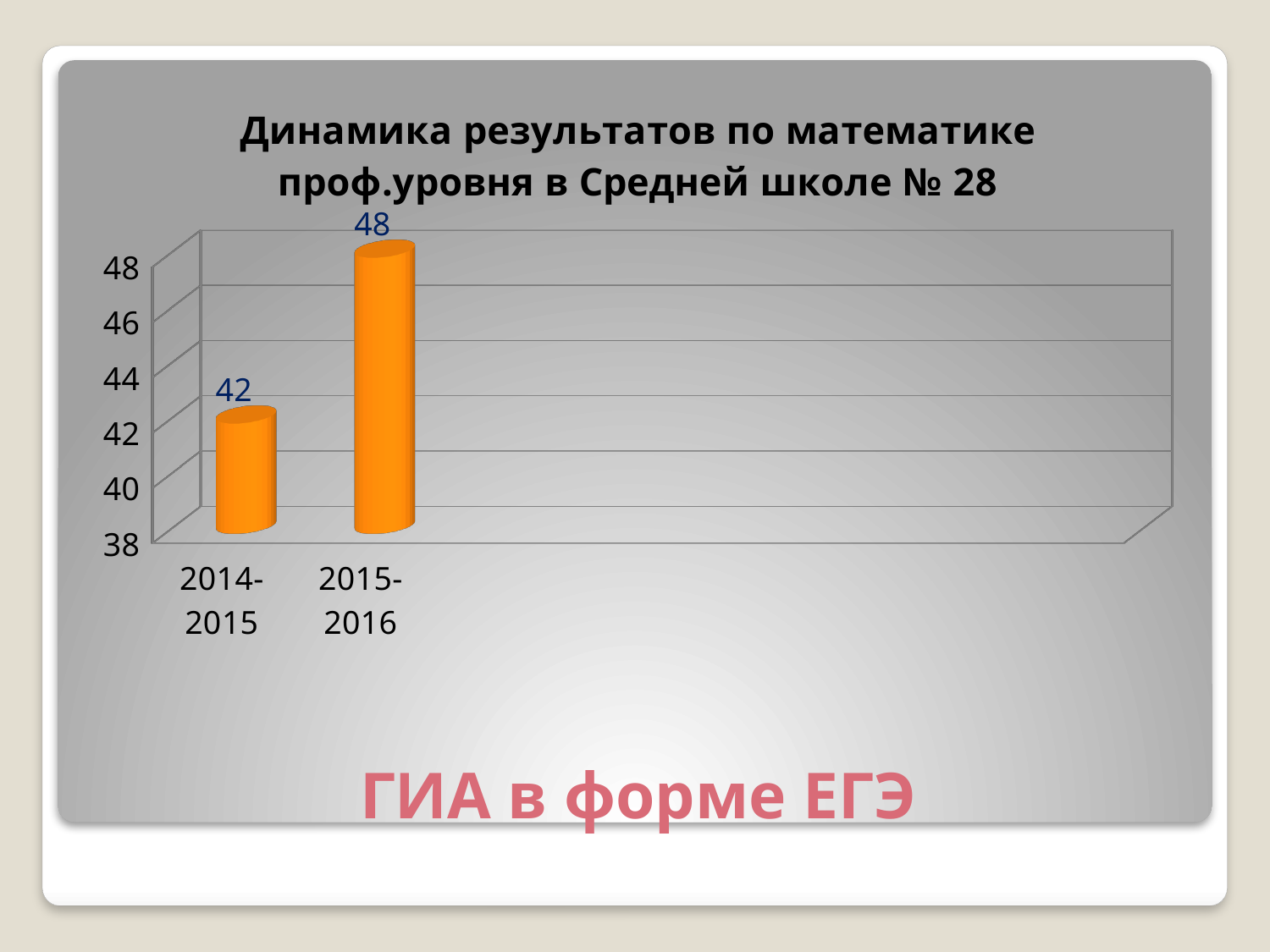
What kind of chart is shown on the slide? bar chart What is the difference between the values for 2015-2016 and 2014-2015? 6 Is the value for 2014-2015 greater or less than 44? less Which year has the highest value? 2015-2016 What is the value for 2014-2015? 42 Do the values rise or fall from 2014-2015 to 2015-2016? rise Which year has the lowest value? 2014-2015 How many categories are shown on the x axis? 2 Which is larger, the value for 2014-2015 or the value for 2015-2016? 2015-2016 What is the value for 2015-2016? 48 Is the value for 2015-2016 greater or less than 46? greater What is the title of the chart? Динамика результатов по математике проф.уровня в Средней школе № 28